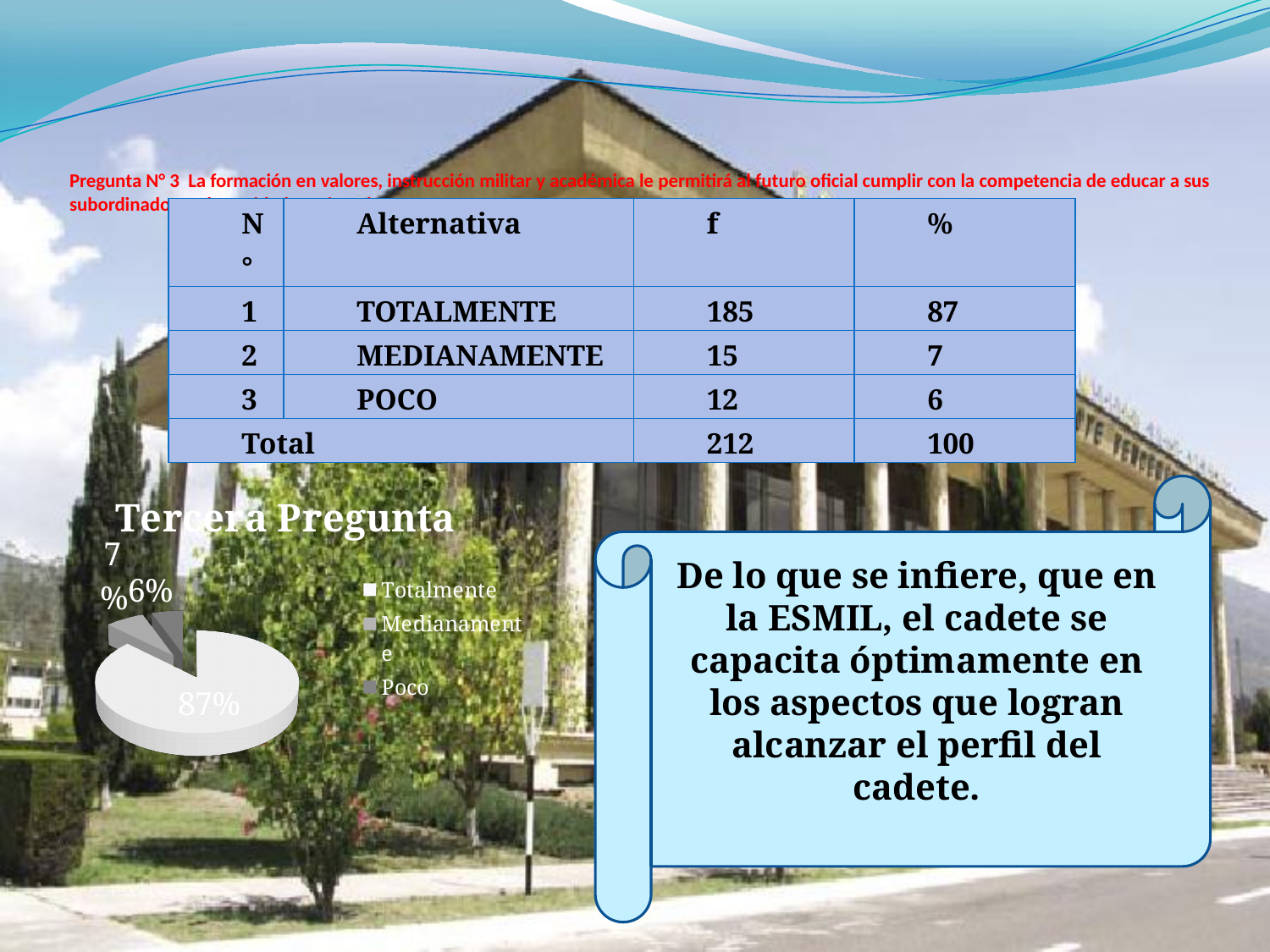
How many entries does the chart legend list? 3 Which slice is larger, Medianamente or Poco? Medianamente What percentage does the Medianamente slice show? 7% What is the difference in percentage points between the Totalmente and Medianamente slices? 80 Which category has the largest slice of the pie? Totalmente What is the title of the chart? Tercera Pregunta What kind of chart is shown on the slide? pie chart Which legend entry is listed first in the chart legend? Totalmente What percentage does the Totalmente slice show? 87% Which category has the smallest slice of the pie? Poco How many slices does the pie chart have? 3 What percentage does the Poco slice show? 6%